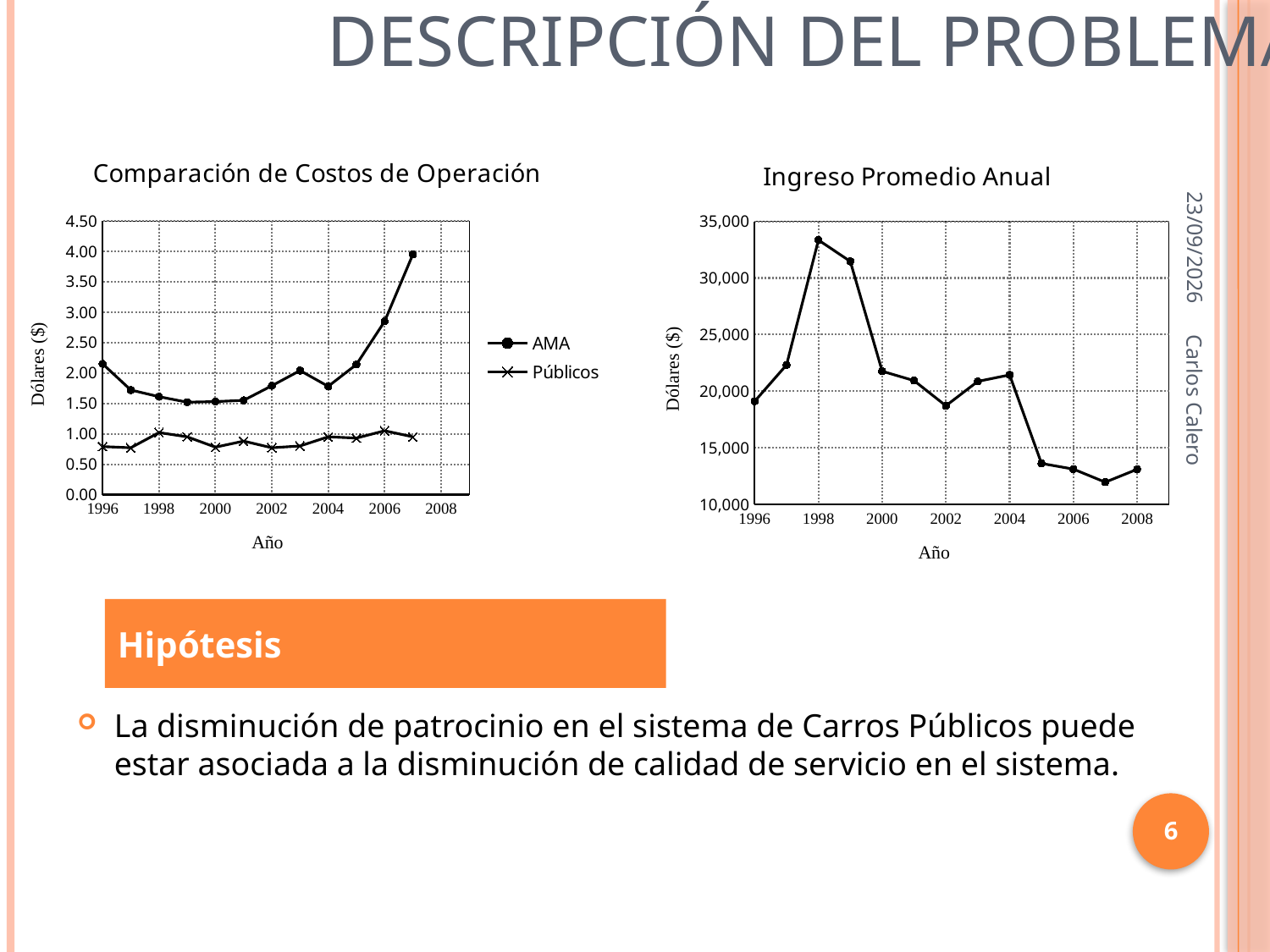
In the 'Ingreso Promedio Anual' chart, is the value for 1998 greater or less than 30,000? greater In the 'Comparación de Costos de Operación' chart, does the AMA series rise or fall from 2004 to 2007? rise In the 'Ingreso Promedio Anual' chart, which year has the lowest value? 2007 In the 'Ingreso Promedio Anual' chart, which year has the highest value? 1998 How many series does the legend of the 'Comparación de Costos de Operación' chart list? 2 In the 'Comparación de Costos de Operación' chart, which series is higher in 2007, AMA or Públicos? AMA In the 'Ingreso Promedio Anual' chart, is the value for 2005 greater or less than 15,000? less What kind of chart is the 'Comparación de Costos de Operación' chart? line chart In the 'Comparación de Costos de Operación' chart, in which year does the AMA series reach its highest value? 2007 In the 'Comparación de Costos de Operación' chart, is the AMA value for 2007 greater or less than 3.50? greater What is the y-axis label of the 'Ingreso Promedio Anual' chart? Dólares ($) How many data points are plotted in the 'Ingreso Promedio Anual' chart? 13